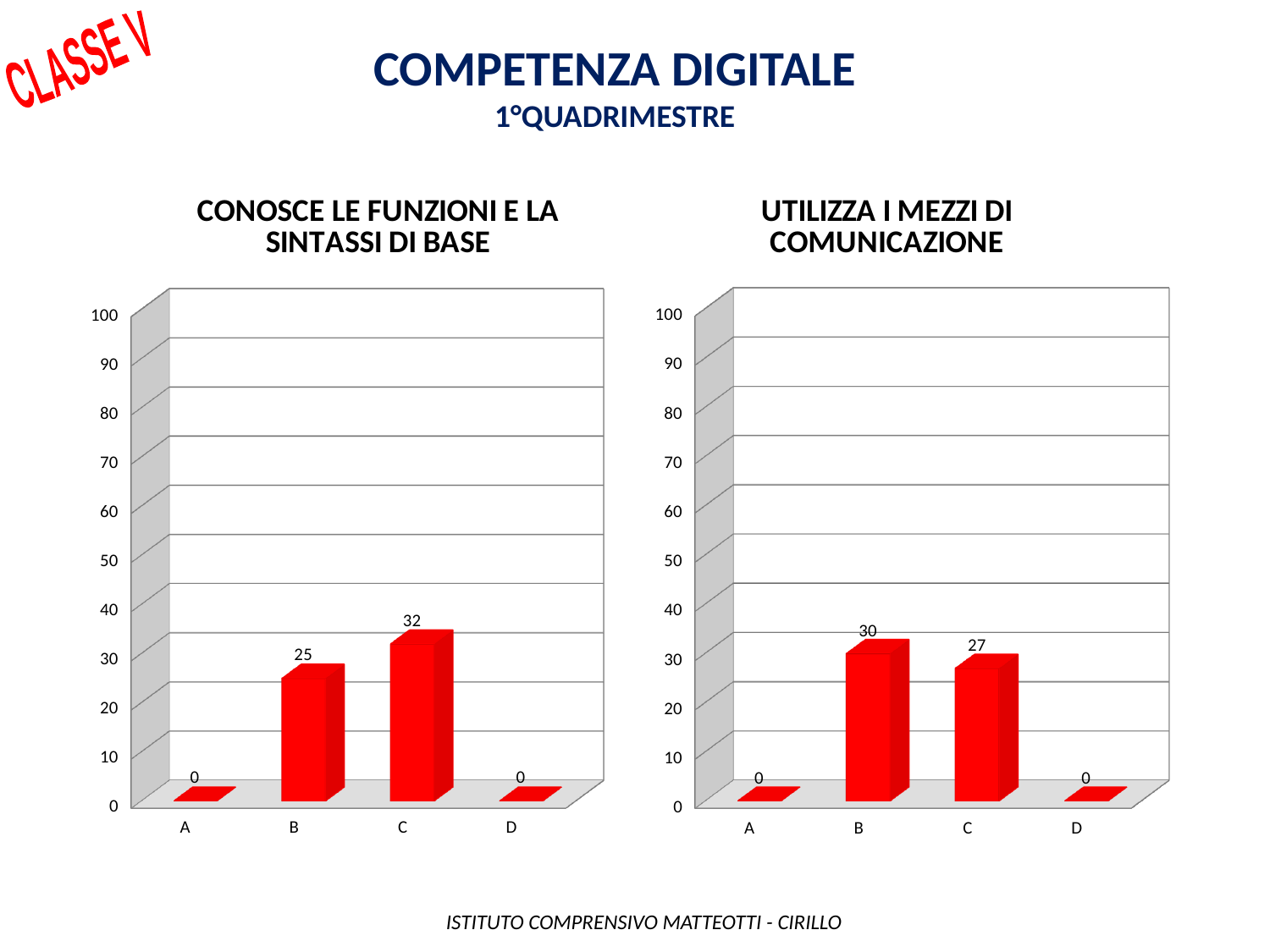
What kind of chart is the chart titled "CONOSCE LE FUNZIONI E LA SINTASSI DI BASE"? Bar chart In the chart titled "UTILIZZA I MEZZI DI COMUNICAZIONE", which category has the highest value? B In the chart titled "CONOSCE LE FUNZIONI E LA SINTASSI DI BASE", what is the value for category B? 25 In the chart titled "UTILIZZA I MEZZI DI COMUNICAZIONE", what is the difference between the values for B and C? 3 In the chart titled "UTILIZZA I MEZZI DI COMUNICAZIONE", which is larger, the value for B or the value for C? B In the chart titled "UTILIZZA I MEZZI DI COMUNICAZIONE", what is the value for category B? 30 In the chart titled "CONOSCE LE FUNZIONI E LA SINTASSI DI BASE", what is the difference between the values for C and B? 7 In the chart titled "CONOSCE LE FUNZIONI E LA SINTASSI DI BASE", is the value for C greater or less than 30? greater In the chart titled "UTILIZZA I MEZZI DI COMUNICAZIONE", what is the value for category C? 27 In the chart titled "CONOSCE LE FUNZIONI E LA SINTASSI DI BASE", which category has the highest value? C In the chart titled "CONOSCE LE FUNZIONI E LA SINTASSI DI BASE", what is the value for category C? 32 How many categories are shown on the x axis of the chart titled "UTILIZZA I MEZZI DI COMUNICAZIONE"? 4